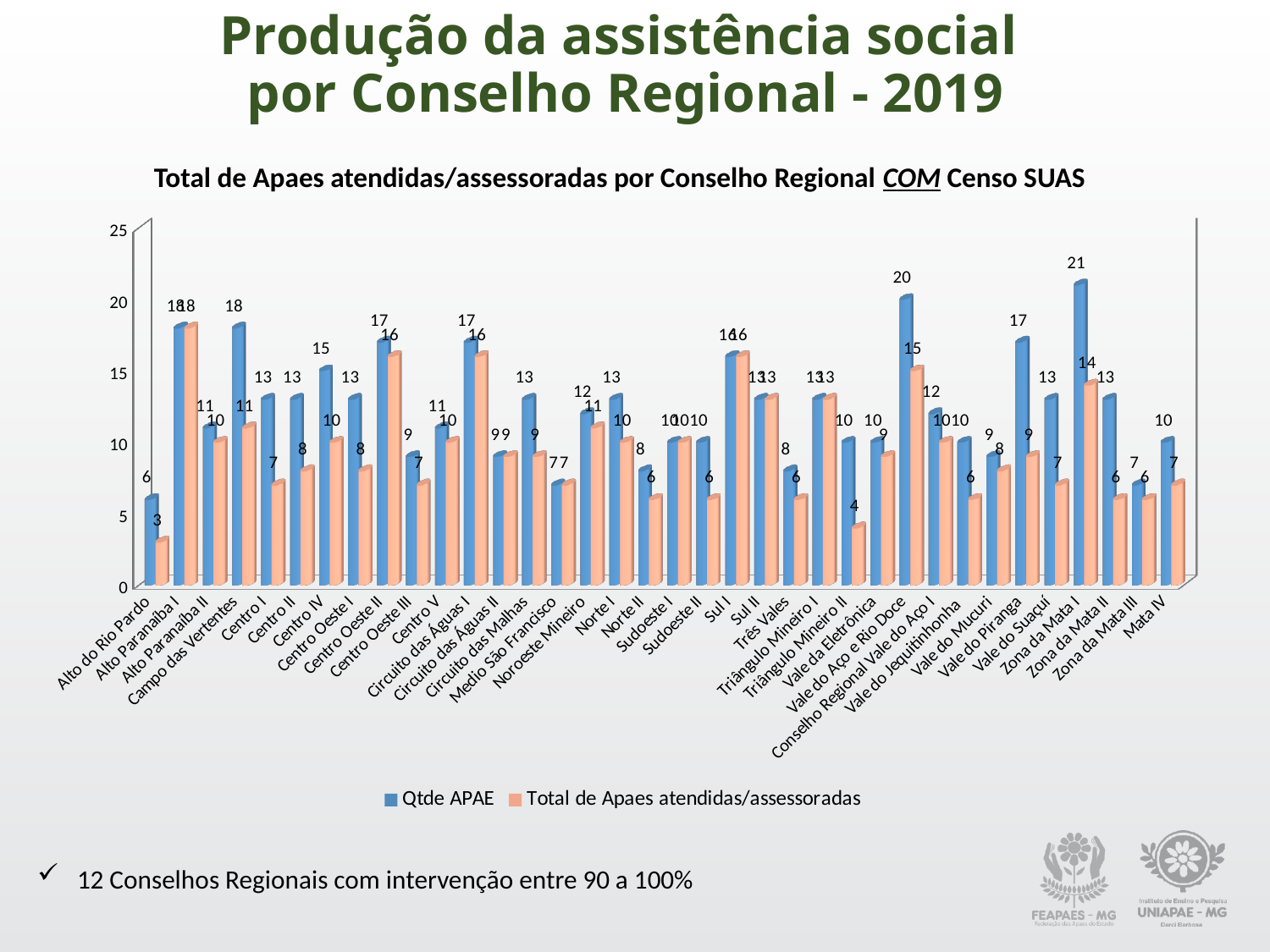
What is the difference between Qtde APAE and Total de Apaes atendidas/assessoradas for Vale do Piranga? 8 Which Conselho Regional has the lowest Total de Apaes atendidas/assessoradas? Alto do Rio Pardo What is the Total de Apaes atendidas/assessoradas value for Triângulo Mineiro II? 4 Which is larger for Alto do Rio Pardo: Qtde APAE or Total de Apaes atendidas/assessoradas? Qtde APAE How many series does the legend list? 2 What type of chart is shown on the slide? bar chart What is the Total de Apaes atendidas/assessoradas value for Vale do Aço e Rio Doce? 15 What is the Qtde APAE value for Zona da Mata I? 21 Which Conselho Regional has the highest Qtde APAE? Zona da Mata I What is the title of the chart? Total de Apaes atendidas/assessoradas por Conselho Regional COM Censo SUAS What is the difference between Qtde APAE and Total de Apaes atendidas/assessoradas for Campo das Vertentes? 7 Is the Qtde APAE value for Vale do Aço e Rio Doce greater or less than 15? greater